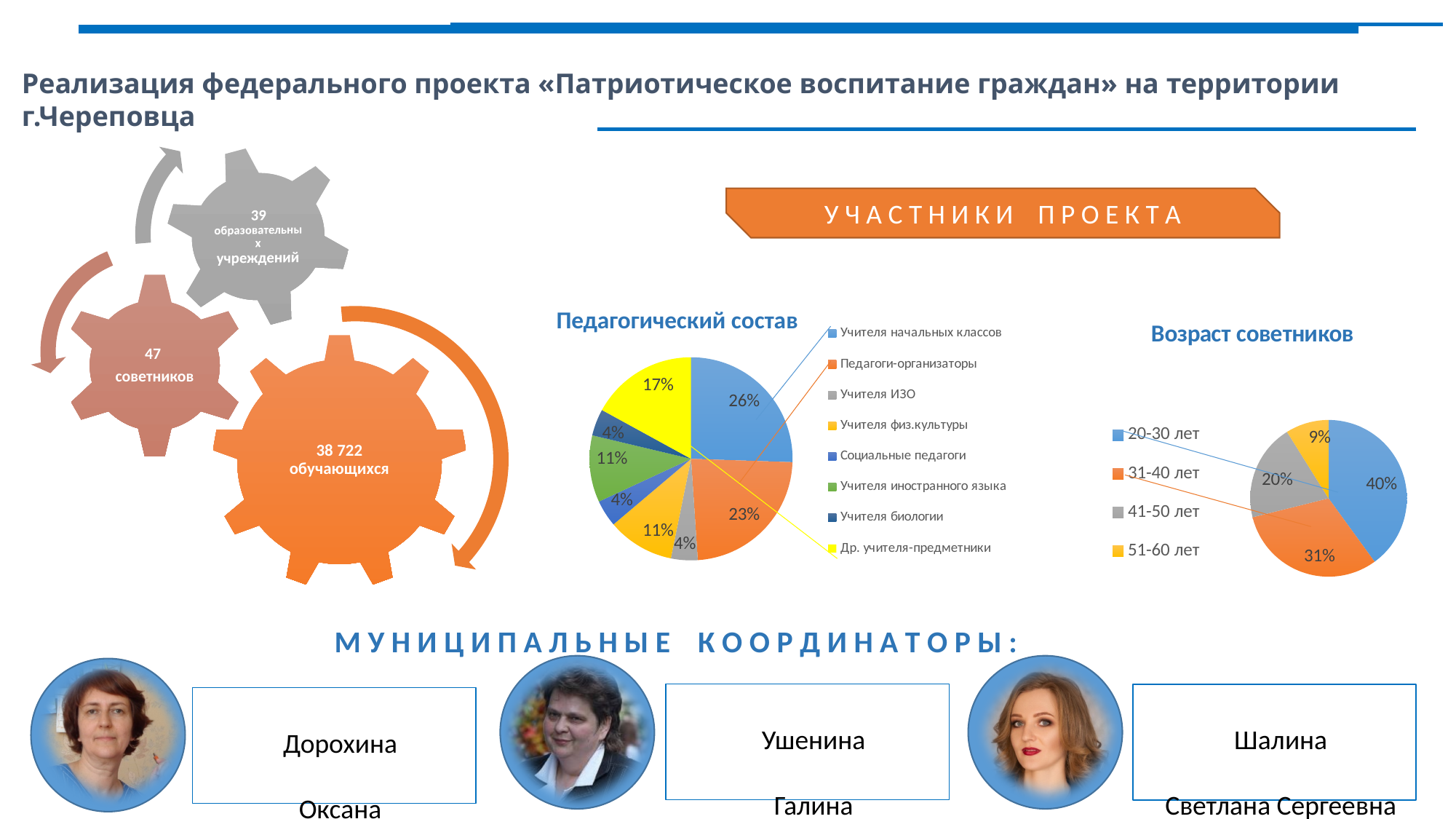
In the chart titled «Педагогический состав», what share do «Учителя начальных классов» have? 26% In the chart titled «Педагогический состав», what share do «Др. учителя-предметники» have? 17% What type of chart is «Возраст советников»? Pie chart In the chart titled «Педагогический состав», what share do «Педагоги-организаторы» have? 23% In the chart titled «Педагогический состав», what is the difference between the shares of «Учителя начальных классов» and «Педагоги-организаторы»? 3% In the chart titled «Возраст советников», how many age groups are shown? 4 In the chart titled «Возраст советников», which age group has the smallest share? 51-60 лет In the chart titled «Педагогический состав», which category has the largest share? Учителя начальных классов In the chart titled «Возраст советников», what share does the «51-60 лет» group have? 9% In the chart titled «Возраст советников», what share does the «20-30 лет» group have? 40% In the chart titled «Возраст советников», which is larger: the share of «31-40 лет» or «41-50 лет»? 31-40 лет In the chart titled «Педагогический состав», how many categories does the legend list? 8